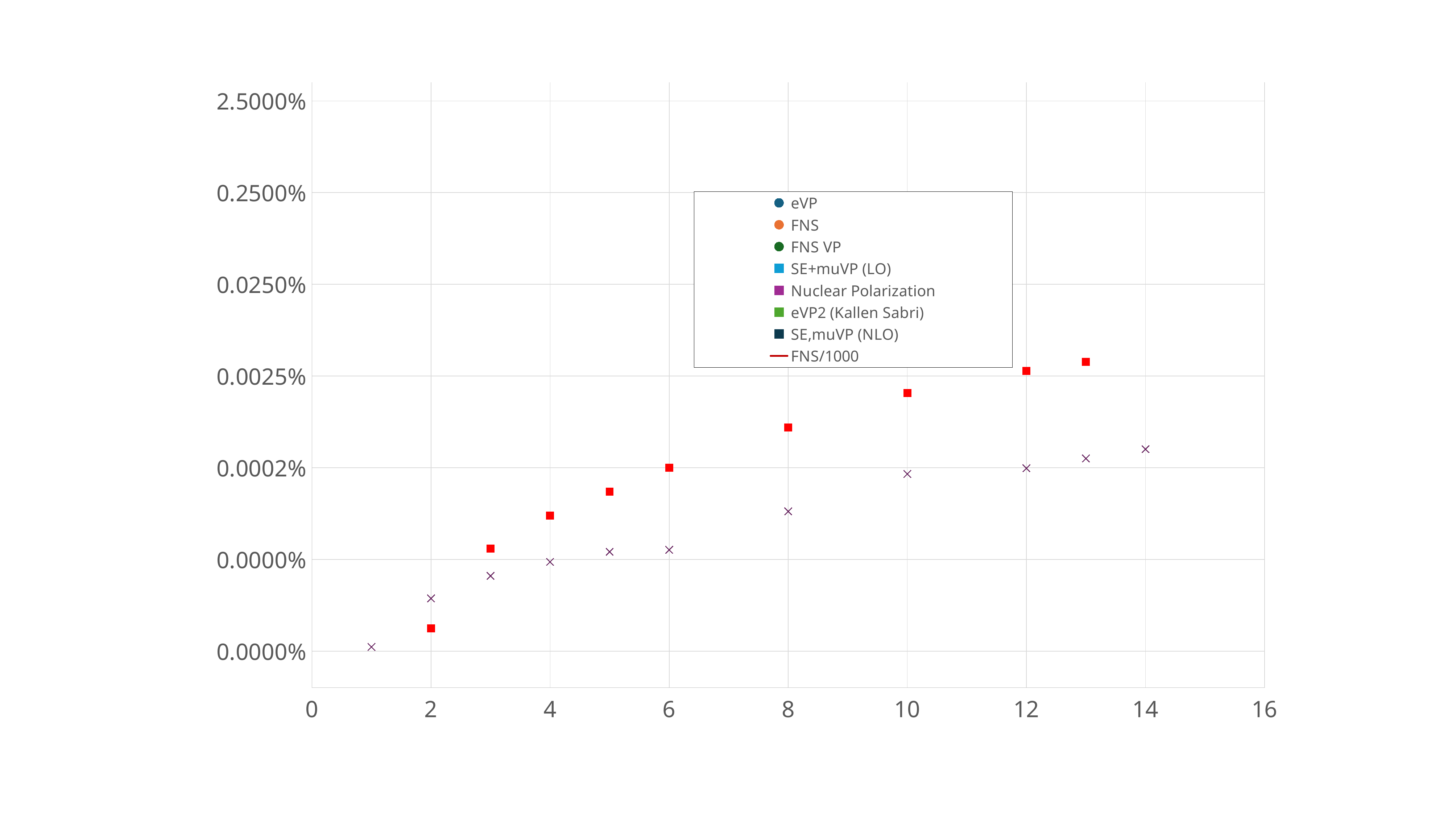
Do the red square markers rise or fall as the x value increases? rise How many purple x markers are plotted on the chart? 11 What kind of chart is shown on the slide? scatter chart How many series does the legend list? 8 What is the highest value labelled on the x axis? 16 Do the purple x markers rise or fall as the x value increases? rise Is the red square marker at x = 13 greater or less than 0.0025%? greater Is the purple x marker at x = 14 greater or less than 0.0025%? less At x = 10, which is higher: the red square marker or the purple x marker? the red square marker What is the last entry listed in the legend? FNS/1000 Is the purple x marker at x = 8 greater or less than 0.0002%? less How many red square markers are plotted on the chart? 9